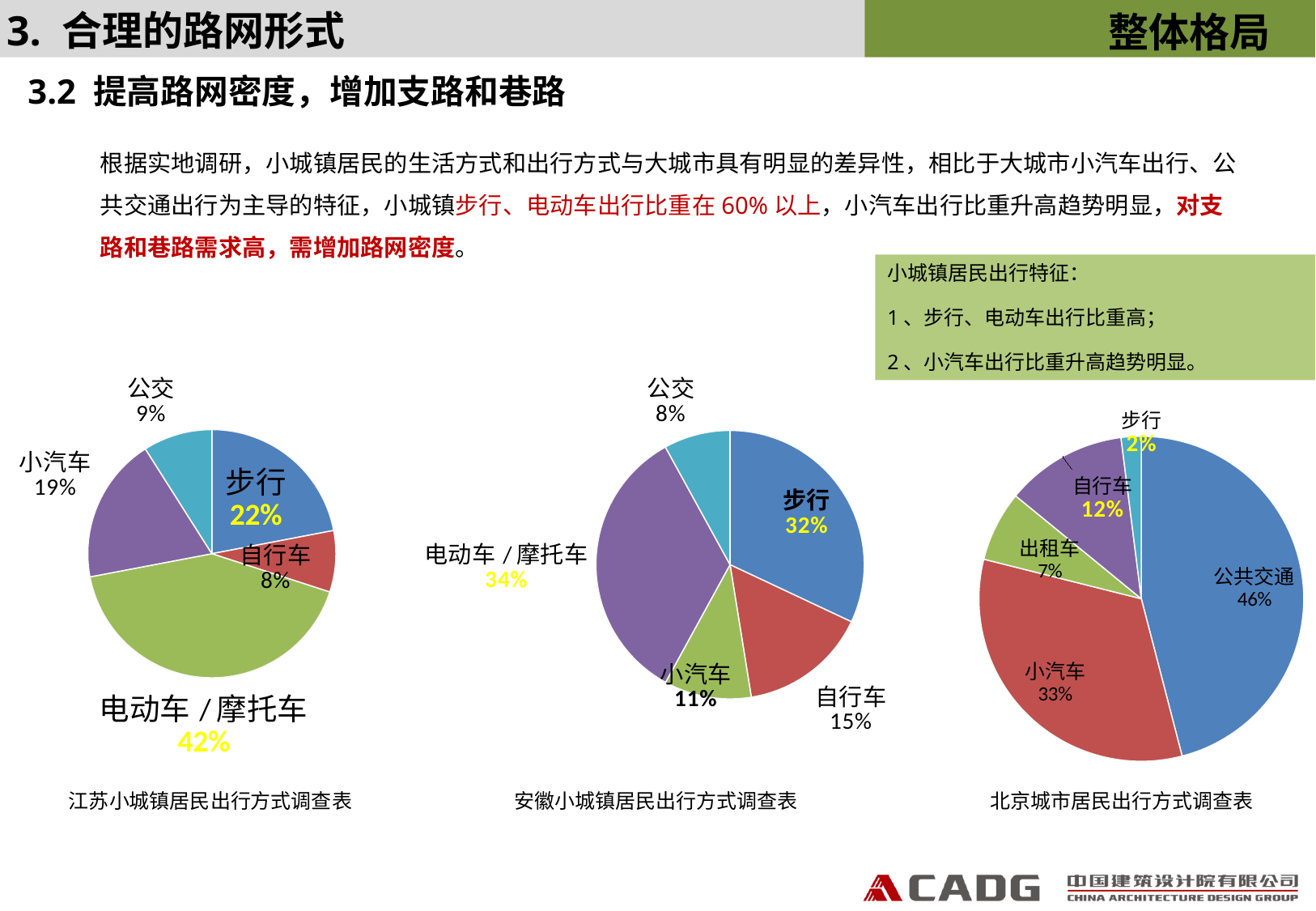
In the 北京城市居民出行方式调查表 pie chart, which category has the smallest share? 步行 In the 安徽小城镇居民出行方式调查表 pie chart, how many categories are shown? 5 In the 江苏小城镇居民出行方式调查表 pie chart, what share is 电动车 / 摩托车? 42% In the 北京城市居民出行方式调查表 pie chart, what is the difference between the 小汽车 share and the 出租车 share? 26% In the 江苏小城镇居民出行方式调查表 pie chart, which category has the smallest share? 自行车 In the 安徽小城镇居民出行方式调查表 pie chart, what share is 步行? 32% In the 安徽小城镇居民出行方式调查表 pie chart, which is larger, 自行车 or 小汽车? 自行车 What kind of chart is the 北京城市居民出行方式调查表? Pie chart In the 安徽小城镇居民出行方式调查表 pie chart, which category has the largest share? 电动车 / 摩托车 How many pie charts are shown on the slide? 3 In the 江苏小城镇居民出行方式调查表 pie chart, what is the difference between the 小汽车 share and the 公交 share? 10% In the 北京城市居民出行方式调查表 pie chart, what share is 公共交通? 46%